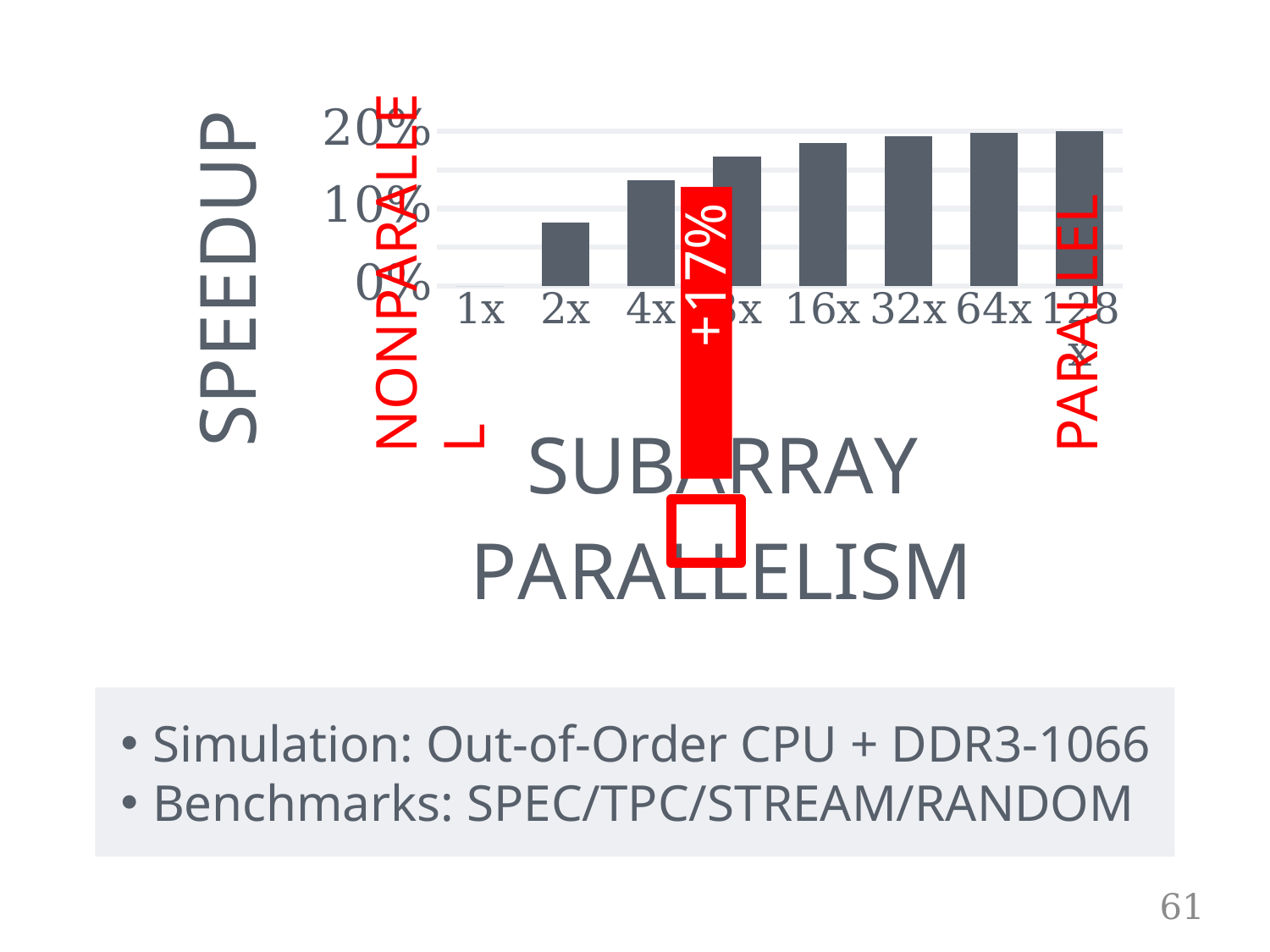
Which has a larger speedup, 4x or 64x? 64x Do the speedup values rise or fall as subarray parallelism increases along the x axis? rise Which has a larger speedup, 2x or 16x? 16x Is the speedup for 16x greater or less than 10%? greater What kind of chart is shown on the slide? bar chart What is the label of the y axis? SPEEDUP What is the label of the x axis? SUBARRAY PARALLELISM Is the speedup for 2x greater or less than 10%? less How many subarray parallelism categories are plotted on the x axis? 8 Is the speedup for 4x greater or less than 10%? greater Which subarray parallelism category has the lowest speedup? 1x